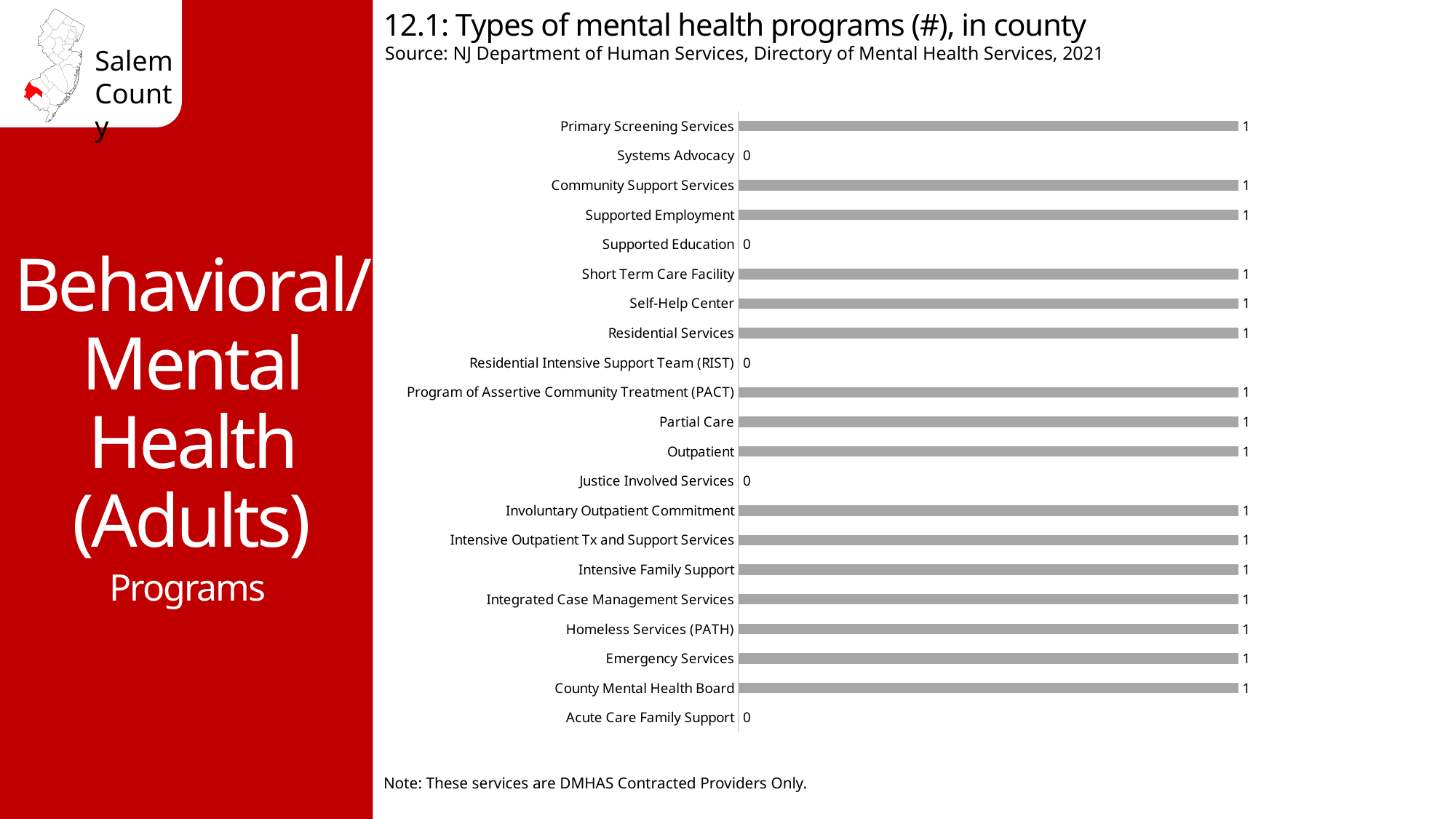
Which is larger, the value for Supported Employment or the value for Supported Education? Supported Employment What kind of chart is shown on the slide? Bar chart What is the value for Homeless Services (PATH)? 1 What is the value for Systems Advocacy? 0 What is the title of the chart? 12.1: Types of mental health programs (#), in county What is the difference between the value for Outpatient and the value for Justice Involved Services? 1 What is the value for Residential Intensive Support Team (RIST)? 0 How many categories have a value of 0? 5 What is the value for Primary Screening Services? 1 What is the value for Acute Care Family Support? 0 How many categories are shown in the chart? 21 What is the value for Program of Assertive Community Treatment (PACT)? 1